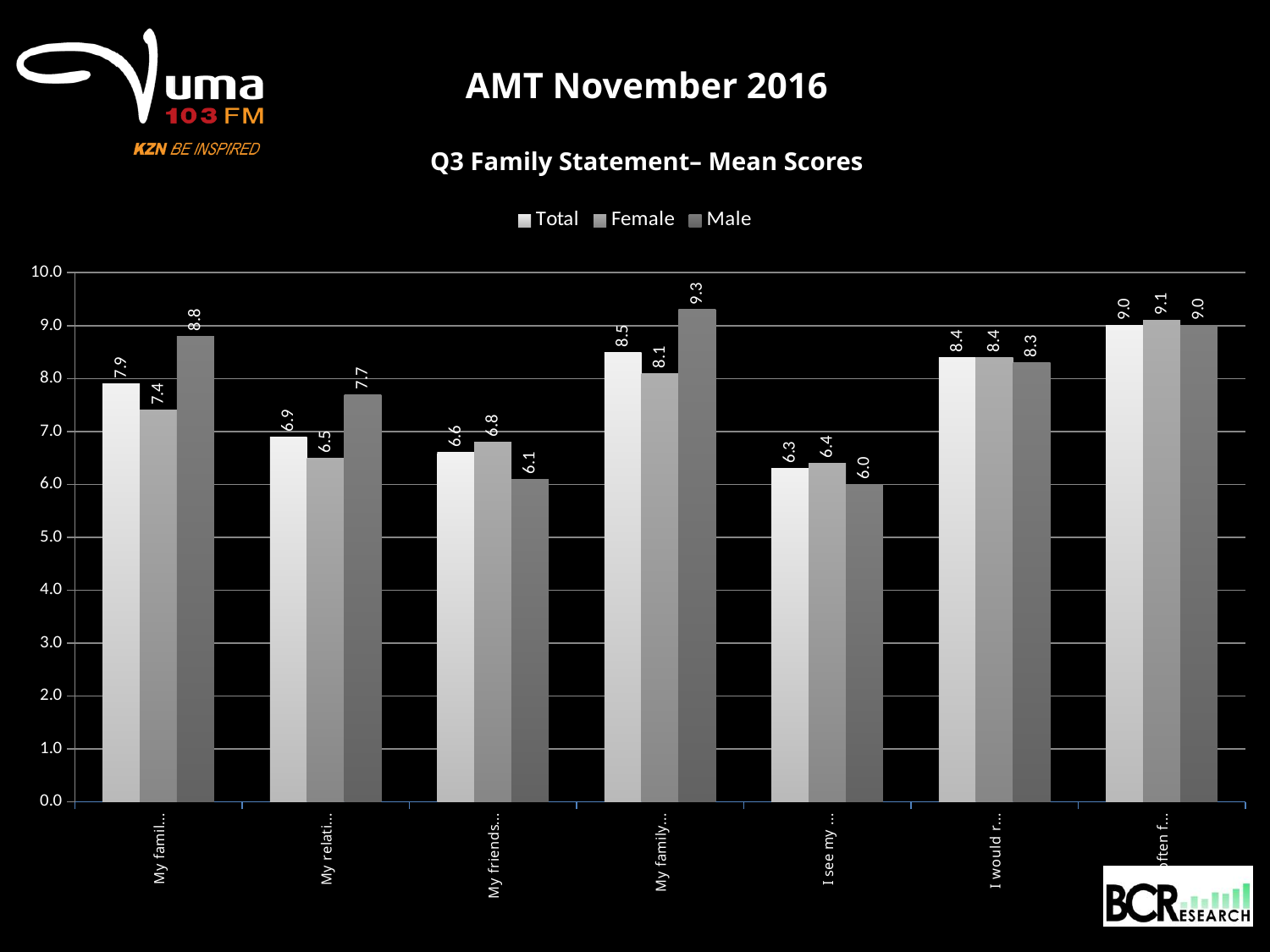
How many category groups are plotted along the x axis? 7 How many series does the legend list? 3 In the first category group from the left, what is the difference between the Male and Female values? 1.4 What is the Female value for the fourth category group from the left? 8.1 What is the Male value for the first category group from the left? 8.8 In the third category group from the left, which is larger, the Female value or the Male value? Female What is the Total value for the second category group from the left? 6.9 What is the lowest Total value shown on the chart? 6.3 What is the highest Male value shown on the chart? 9.3 What kind of chart is shown on the slide? bar chart What is the title of the chart? Q3 Family Statement– Mean Scores In the fifth category group from the left, is the Male value greater or less than 7.0? less